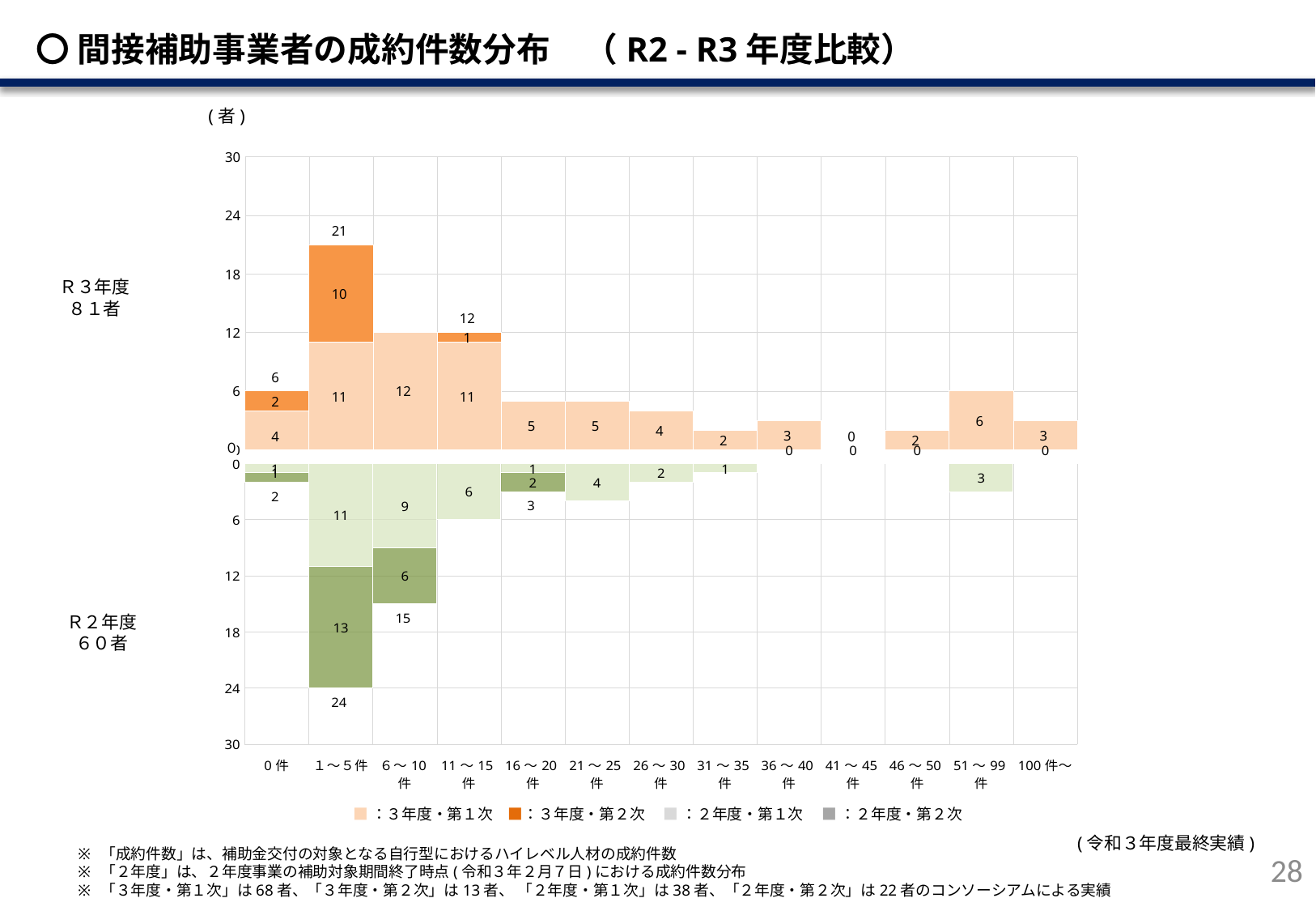
What is the total number of R2年度 businesses in the 1～5件 category? 24 What kind of chart is shown on the slide? bar chart What is the value for 3年度・第2次 in the 1～5件 category? 10 What is the total number of R3年度 businesses in the 1～5件 category? 21 What is the difference between the R3年度 total and the R2年度 total in the 6～10件 category? 3 Which category has the highest total for R3年度? 1～5件 What is the value for 2年度・第2次 in the 6～10件 category? 6 How many contract-count categories are shown on the x axis? 13 How many series does the legend list? 4 What is the value for 2年度・第1次 in the 11～15件 category? 6 What is the value for 3年度・第1次 in the 6～10件 category? 12 Which is larger in the 51～99件 category: the R3年度 value or the R2年度 value? R3年度